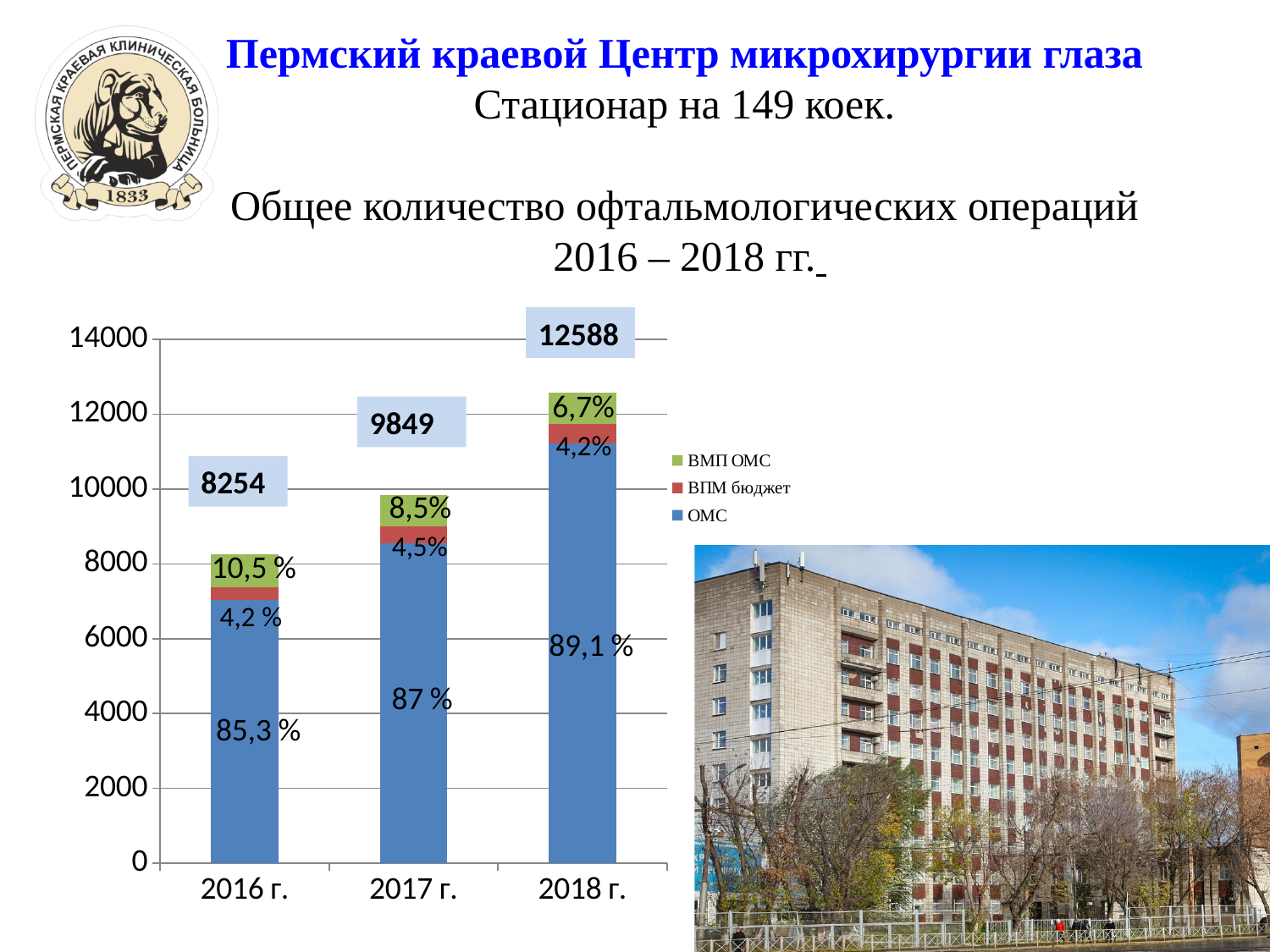
What is the total number of operations shown for 2016 г.? 8254 What is the total number of ophthalmological operations shown for 2018 г.? 12588 Which year has the highest total number of operations? 2018 г. What is the difference between the total for 2017 г. and the total for 2016 г.? 1595 What percentage label is shown on the ОМС segment of the 2017 г. bar? 87 % What percentage label is shown on the ВМП ОМС segment of the 2016 г. bar? 10,5 % What percentage label is shown on the ВПМ бюджет segment of the 2018 г. bar? 4,2% Which year has the lowest total number of operations? 2016 г. What kind of chart is shown on the slide? Stacked bar chart What is the difference between the total for 2018 г. and the total for 2016 г.? 4334 How many series does the legend list? 3 Do the total numbers of operations rise or fall from 2016 г. to 2018 г.? Rise